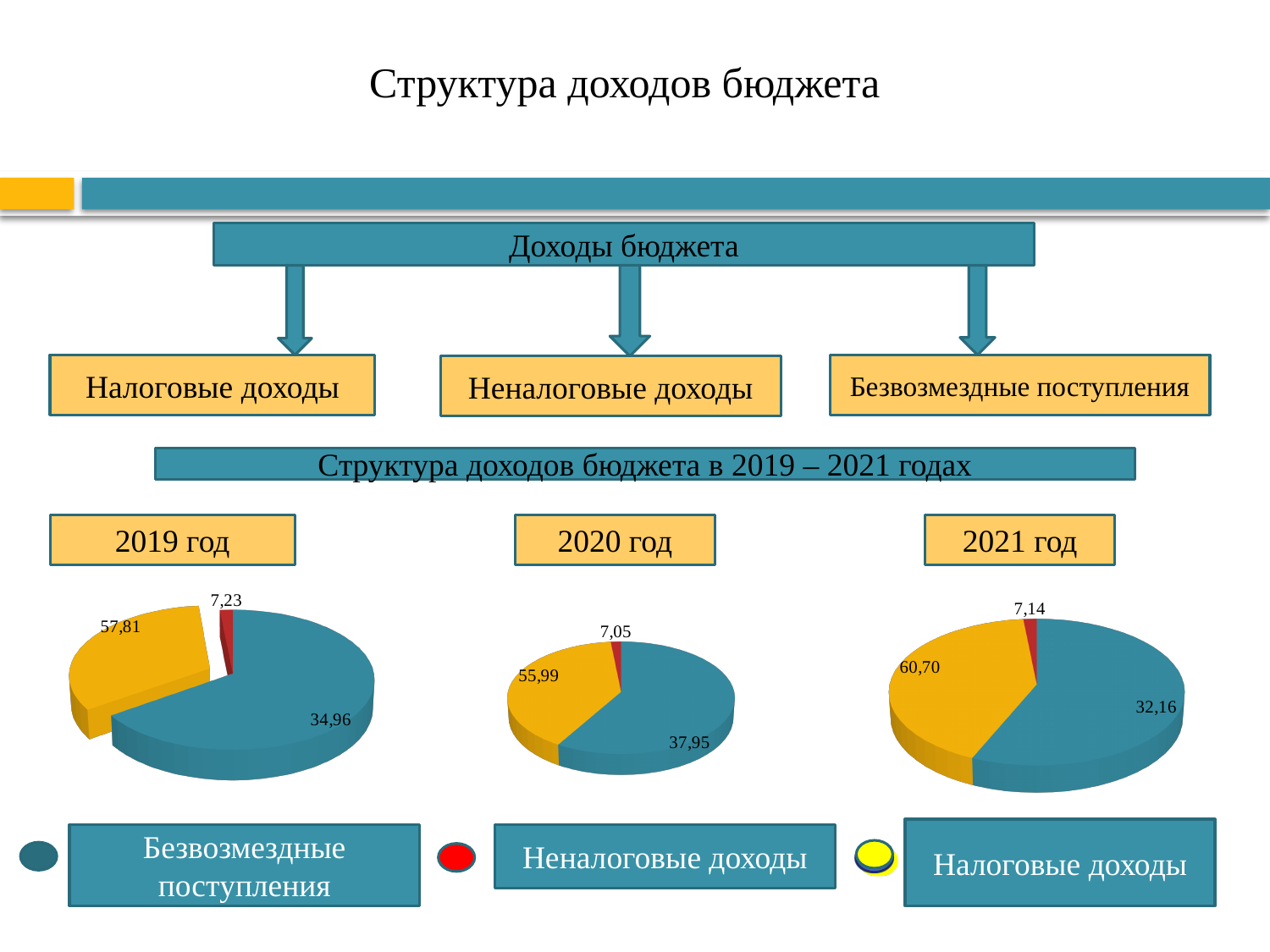
How many slices does each pie chart have? 3 In the 2019 год pie chart, what is the value of the yellow slice? 57,81 In the 2021 год pie chart, what is the value of the red slice? 7,14 In the 2019 год pie chart, what is the difference between the yellow slice and the teal slice? 22,85 In the 2021 год pie chart, what is the value of the yellow slice (Налоговые доходы)? 60,70 How many categories does the legend below the pie charts list? 3 In the 2020 год pie chart, which slice is the smallest? Неналоговые доходы (7,05) In the 2020 год pie chart, what is the value of the teal slice? 37,95 In the 2019 год pie chart, what is the value of the red slice (Неналоговые доходы)? 7,23 What kind of charts are shown for 2019, 2020 and 2021? Pie charts